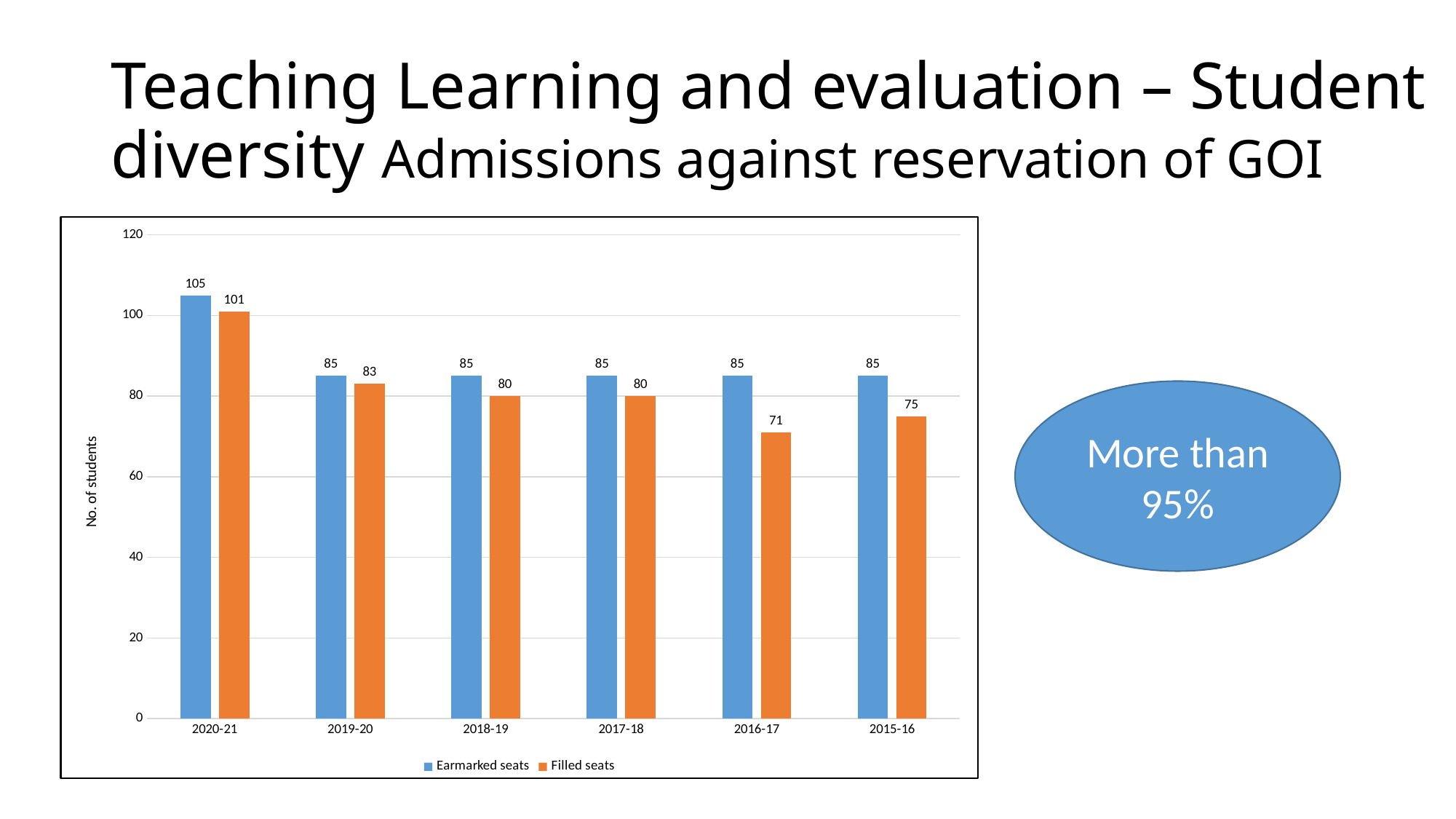
What is the difference between Earmarked seats and Filled seats in 2019-20? 2 What is the value for Filled seats in 2015-16? 75 How many years are shown on the x axis? 6 Is the value for Filled seats in 2020-21 greater or less than 100? greater Which year has the highest value for Filled seats? 2020-21 What is the value for Earmarked seats in 2020-21? 105 What kind of chart is shown on the slide? Bar chart Which year has the lowest value for Filled seats? 2016-17 What is the difference between Earmarked seats and Filled seats in 2015-16? 10 What is the value for Filled seats in 2016-17? 71 How many series does the legend list? 2 Which is larger in 2018-19, Earmarked seats or Filled seats? Earmarked seats